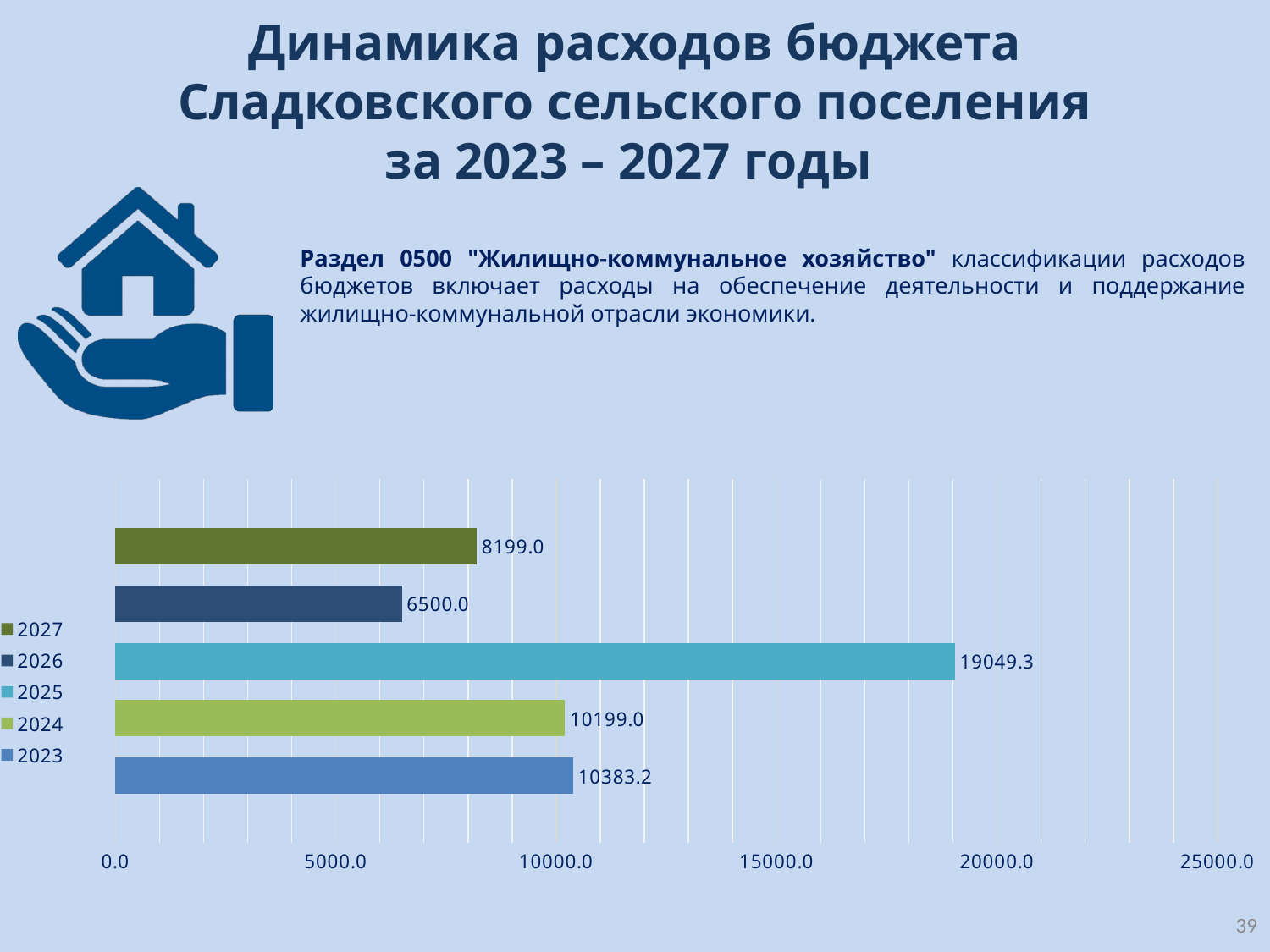
What kind of chart is shown on the slide? bar chart What is the value for 2026? 6500.0 What is the difference between the values for 2025 and 2026? 12549.3 What is the value for 2025? 19049.3 What is the difference between the values for 2023 and 2024? 184.2 Is the value for 2025 greater or less than 15000.0? greater Which is larger, the value for 2027 or the value for 2026? 2027 What is the value for 2027? 8199.0 How many series does the legend list? 5 What is the value for 2023? 10383.2 Which year has the lowest value? 2026 Which year has the highest value? 2025